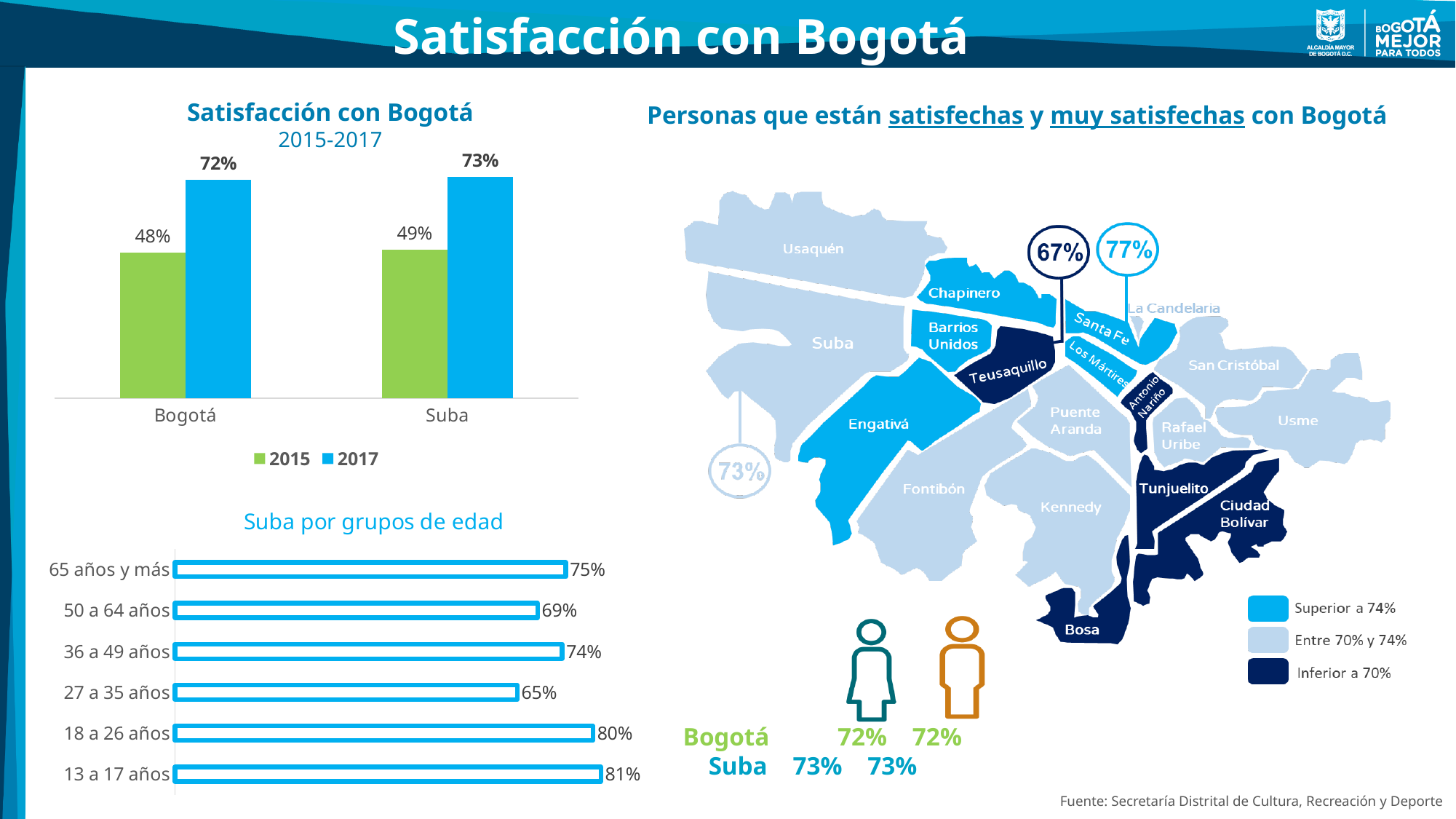
In the 'Satisfacción con Bogotá 2015-2017' chart, what is the value for Suba in 2017? 73% In the 'Satisfacción con Bogotá 2015-2017' chart, what is the difference between the 2017 and 2015 values for Bogotá? 24 percentage points What kind of chart is 'Suba por grupos de edad'? Bar chart In the 'Satisfacción con Bogotá 2015-2017' chart, which is larger: Suba in 2015 or Bogotá in 2015? Suba in 2015 In the 'Suba por grupos de edad' chart, how many age groups are shown? 6 In the 'Satisfacción con Bogotá 2015-2017' chart, how many series does the legend list? 2 In the 'Satisfacción con Bogotá 2015-2017' chart, what is the value for Bogotá in 2015? 48% In the 'Suba por grupos de edad' chart, what is the difference between the values for 18 a 26 años and 36 a 49 años? 6 percentage points In the 'Satisfacción con Bogotá 2015-2017' chart, which colour represents 2017? Blue In the 'Suba por grupos de edad' chart, which age group has the lowest value? 27 a 35 años In the 'Suba por grupos de edad' chart, which age group has the highest value? 13 a 17 años In the 'Suba por grupos de edad' chart, what is the value for 50 a 64 años? 69%